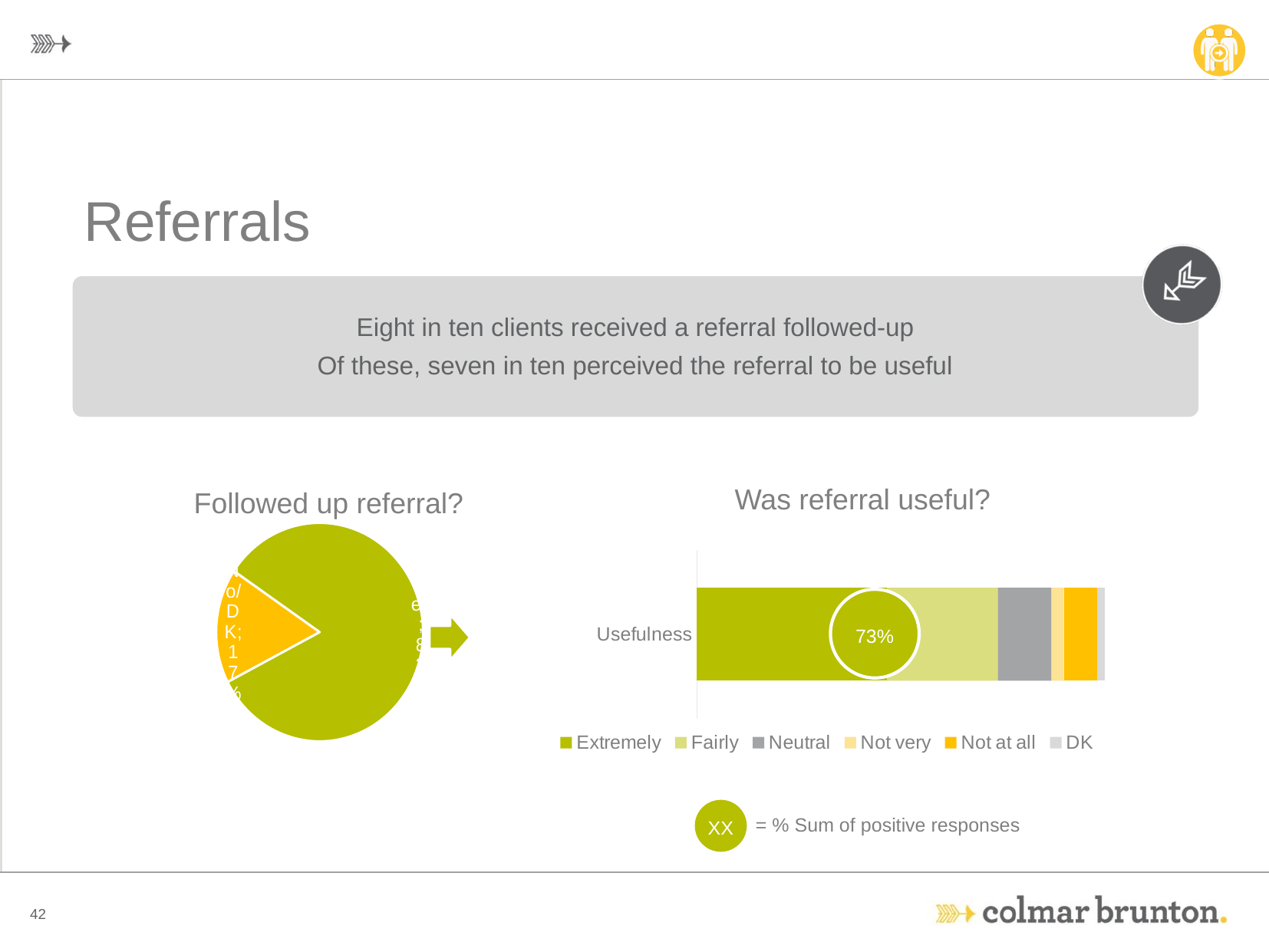
In the 'Was referral useful?' chart, which segment is larger, Extremely or Fairly? Extremely In the 'Was referral useful?' chart, what is the first entry in the legend? Extremely What kind of chart is 'Followed up referral?'? pie chart In the 'Was referral useful?' chart, which segment is larger, Neutral or Not at all? Neutral In the 'Was referral useful?' chart, what is the sum of positive responses shown in the circle on the Usefulness bar? 73% According to the note below the 'Was referral useful?' chart, what does the green circle labelled XX represent? % Sum of positive responses In the 'Was referral useful?' chart, how many categories are plotted on the axis? 1 In the 'Followed up referral?' pie chart, which slice is larger, the green one or the orange one? the green one In the 'Was referral useful?' chart, which response segment is the largest in the Usefulness bar? Extremely In the 'Was referral useful?' chart, how many series does the legend list? 6 What kind of chart is 'Was referral useful?'? bar chart